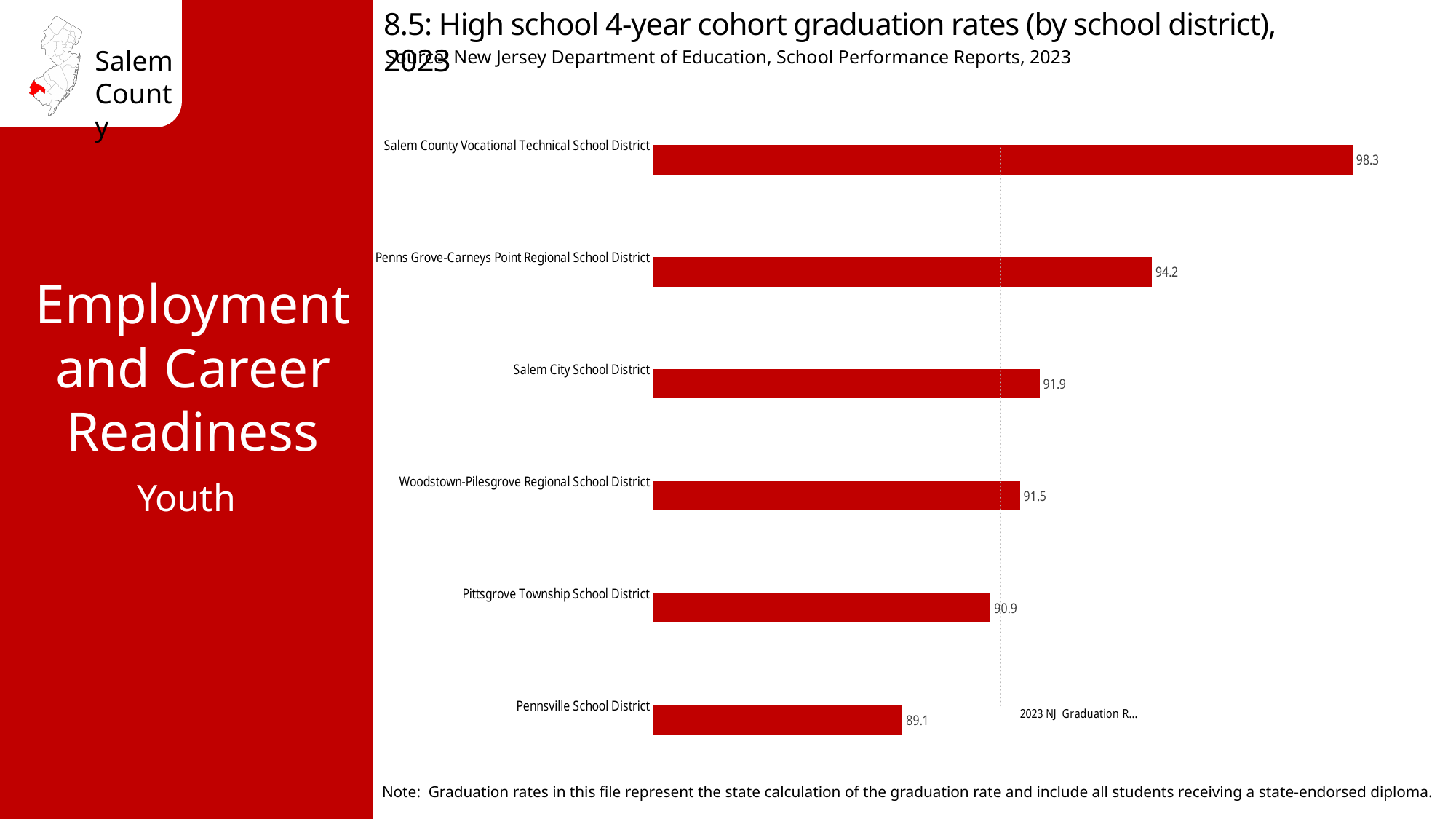
What is the 4-year cohort graduation rate for Salem County Vocational Technical School District? 98.3 Which has a higher graduation rate, Penns Grove-Carneys Point Regional School District or Salem City School District? Penns Grove-Carneys Point Regional School District How many school districts are shown on the chart? 6 What is the graduation rate shown for Pennsville School District? 89.1 What is the graduation rate shown for Penns Grove-Carneys Point Regional School District? 94.2 What is the difference between the graduation rates of Salem County Vocational Technical School District and Pennsville School District? 9.2 What is the graduation rate shown for Pittsgrove Township School District? 90.9 What is the source of the data shown in the chart? New Jersey Department of Education, School Performance Reports, 2023 What is the difference between the graduation rates of Salem City School District and Woodstown-Pilesgrove Regional School District? 0.4 Which school district has the lowest graduation rate on the chart? Pennsville School District What kind of chart is used on this slide? Bar chart Which school district has the highest graduation rate on the chart? Salem County Vocational Technical School District